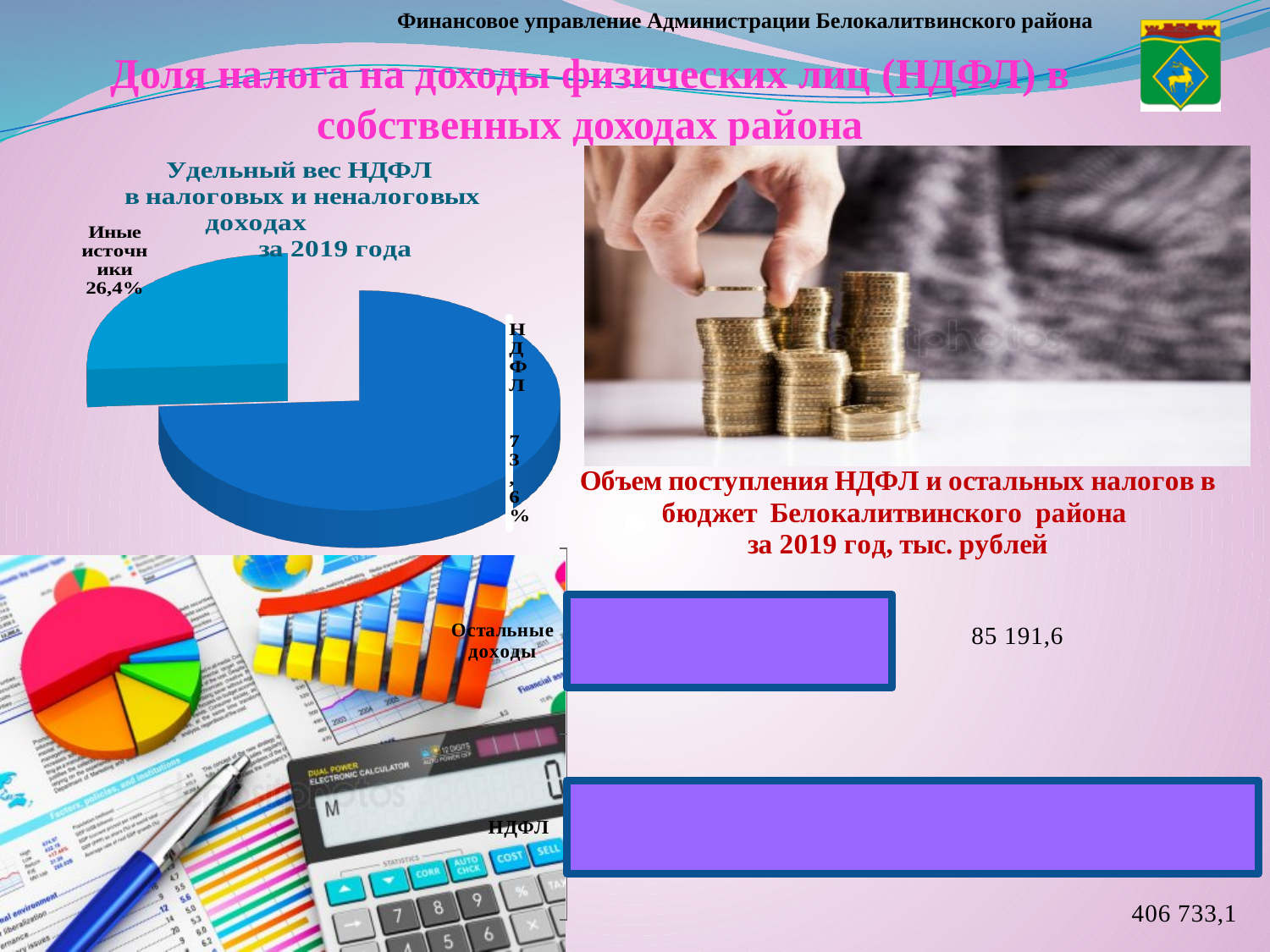
What type of chart is the one in the upper left of the slide? Pie chart On the bar chart 'Объем поступления НДФЛ и остальных налогов в бюджет Белокалитвинского района за 2019 год, тыс. рублей', what is the difference between НДФЛ and Остальные доходы? 321 541,5 What type of chart is the one in the lower right of the slide? Bar chart On the bar chart 'Объем поступления НДФЛ и остальных налогов в бюджет Белокалитвинского района за 2019 год, тыс. рублей', how many bars are shown? 2 On the pie chart 'Удельный вес НДФЛ в налоговых и неналоговых доходах за 2019 года', by how many percentage points does НДФЛ exceed Иные источники? 47,2 On the pie chart 'Удельный вес НДФЛ в налоговых и неналоговых доходах за 2019 года', what share do Иные источники have? 26,4% On the pie chart 'Удельный вес НДФЛ в налоговых и неналоговых доходах за 2019 года', which slice is the largest? НДФЛ On the bar chart 'Объем поступления НДФЛ и остальных налогов в бюджет Белокалитвинского района за 2019 год, тыс. рублей', which category has the higher value? НДФЛ On the bar chart 'Объем поступления НДФЛ и остальных налогов в бюджет Белокалитвинского района за 2019 год, тыс. рублей', what is the value for НДФЛ? 406 733,1 On the pie chart 'Удельный вес НДФЛ в налоговых и неналоговых доходах за 2019 года', what share does НДФЛ have? 73,6% On the pie chart 'Удельный вес НДФЛ в налоговых и неналоговых доходах за 2019 года', how many slices are there? 2 On the bar chart 'Объем поступления НДФЛ и остальных налогов в бюджет Белокалитвинского района за 2019 год, тыс. рублей', what is the value for Остальные доходы? 85 191,6